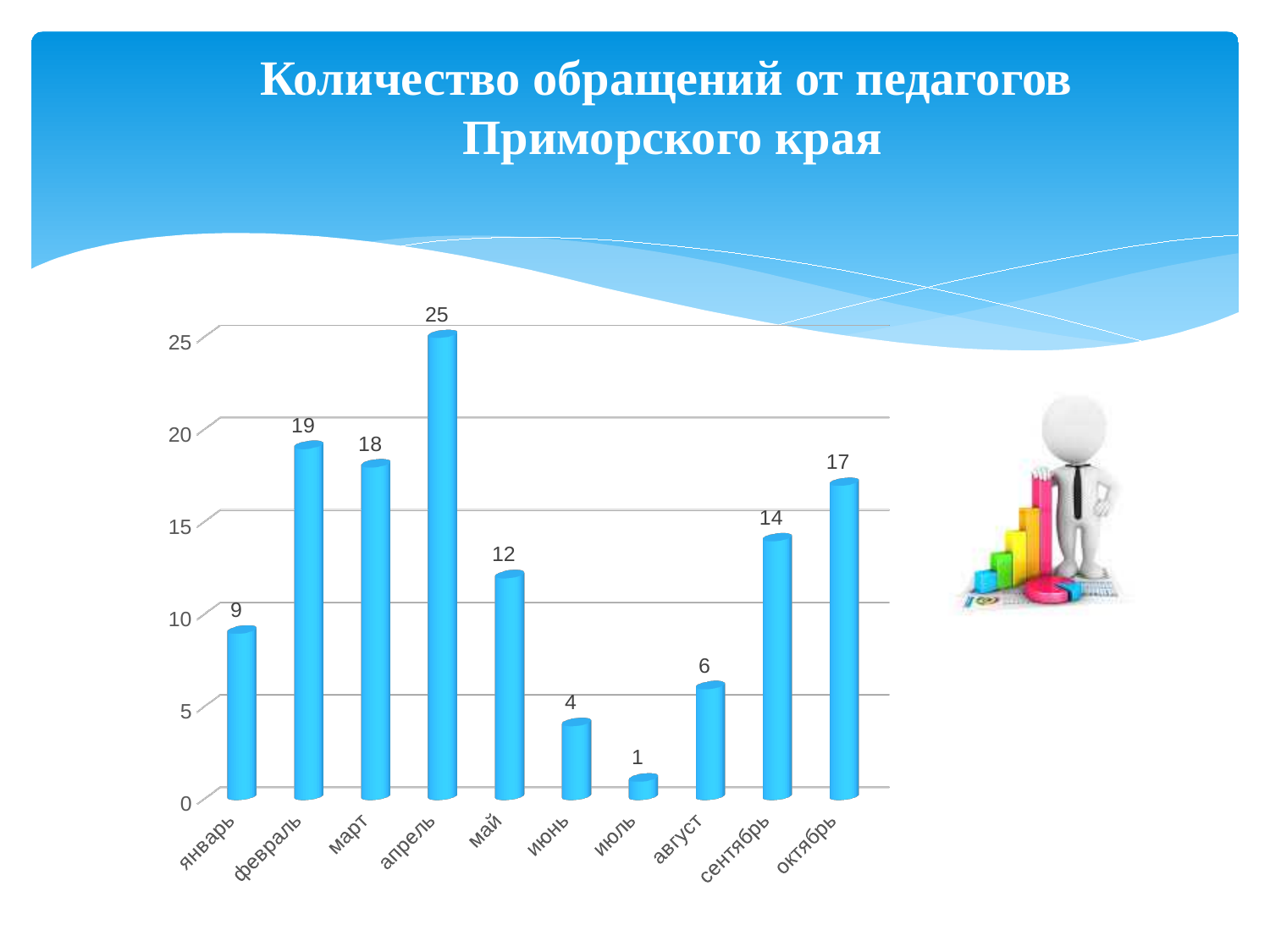
What is the difference between the values for февраль and март? 1 Which month has the lowest value? июль Which is larger, the value for октябрь or the value for сентябрь? октябрь What is the difference between the values for апрель and май? 13 What is the value for сентябрь? 14 What is the title of the slide? Количество обращений от педагогов Приморского края How many months are shown on the x axis? 10 Is the value for январь greater or less than 10? less What is the value for апрель? 25 What kind of chart is shown on the slide? bar chart Which month has the highest value? апрель What is the value for июль? 1